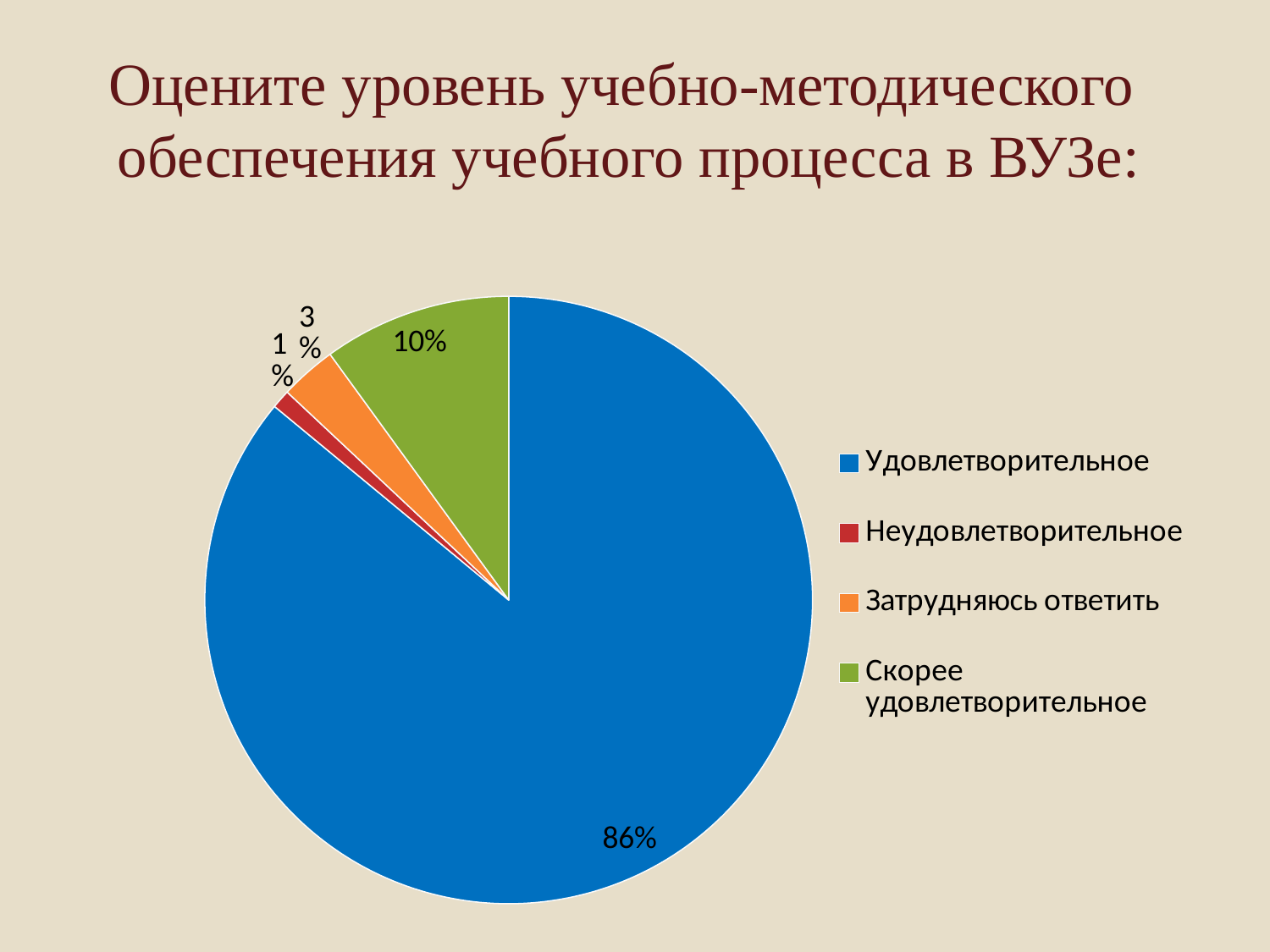
What share of the pie does "Скорее удовлетворительное" take? 10% Which is larger: the share of "Затрудняюсь ответить" or the share of "Неудовлетворительное"? Затрудняюсь ответить What is the difference between the shares of "Удовлетворительное" and "Скорее удовлетворительное"? 76% Which category has the largest slice of the pie? Удовлетворительное What colour is the slice for "Скорее удовлетворительное"? green What share of the pie does "Удовлетворительное" take? 86% What share of the pie does "Затрудняюсь ответить" take? 3% What kind of chart is shown on the slide? pie chart Which category has the smallest slice of the pie? Неудовлетворительное How many slices does the pie chart have? 4 How many entries does the legend list? 4